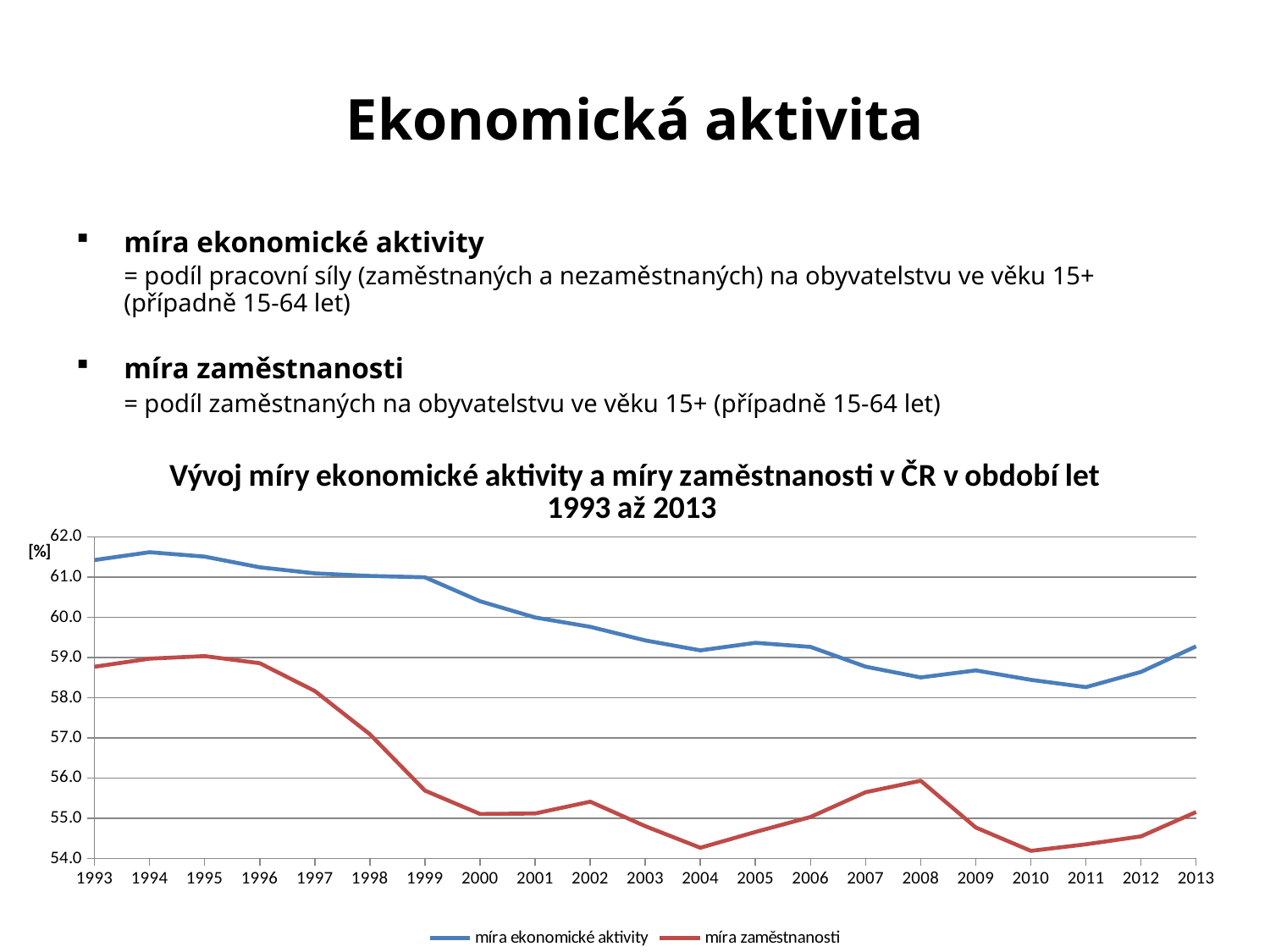
What is the title of the chart? Vývoj míry ekonomické aktivity a míry zaměstnanosti v ČR v období let 1993 až 2013 Which series is drawn in red in the chart? míra zaměstnanosti Does míra ekonomické aktivity generally rise or fall from 1993 to 2011? fall Is the value of míra zaměstnanosti in 1999 greater or less than 55.0? greater What kind of chart is shown on the slide? line chart How many series does the chart legend list? 2 Which series has the higher value in 2000, míra ekonomické aktivity or míra zaměstnanosti? míra ekonomické aktivity In which year is míra ekonomické aktivity at its lowest? 2011 How many years are plotted along the x axis of the chart? 21 Is the value of míra ekonomické aktivity in 1994 greater or less than 61.0? greater Is the value of míra ekonomické aktivity in 2011 greater or less than 59.0? less